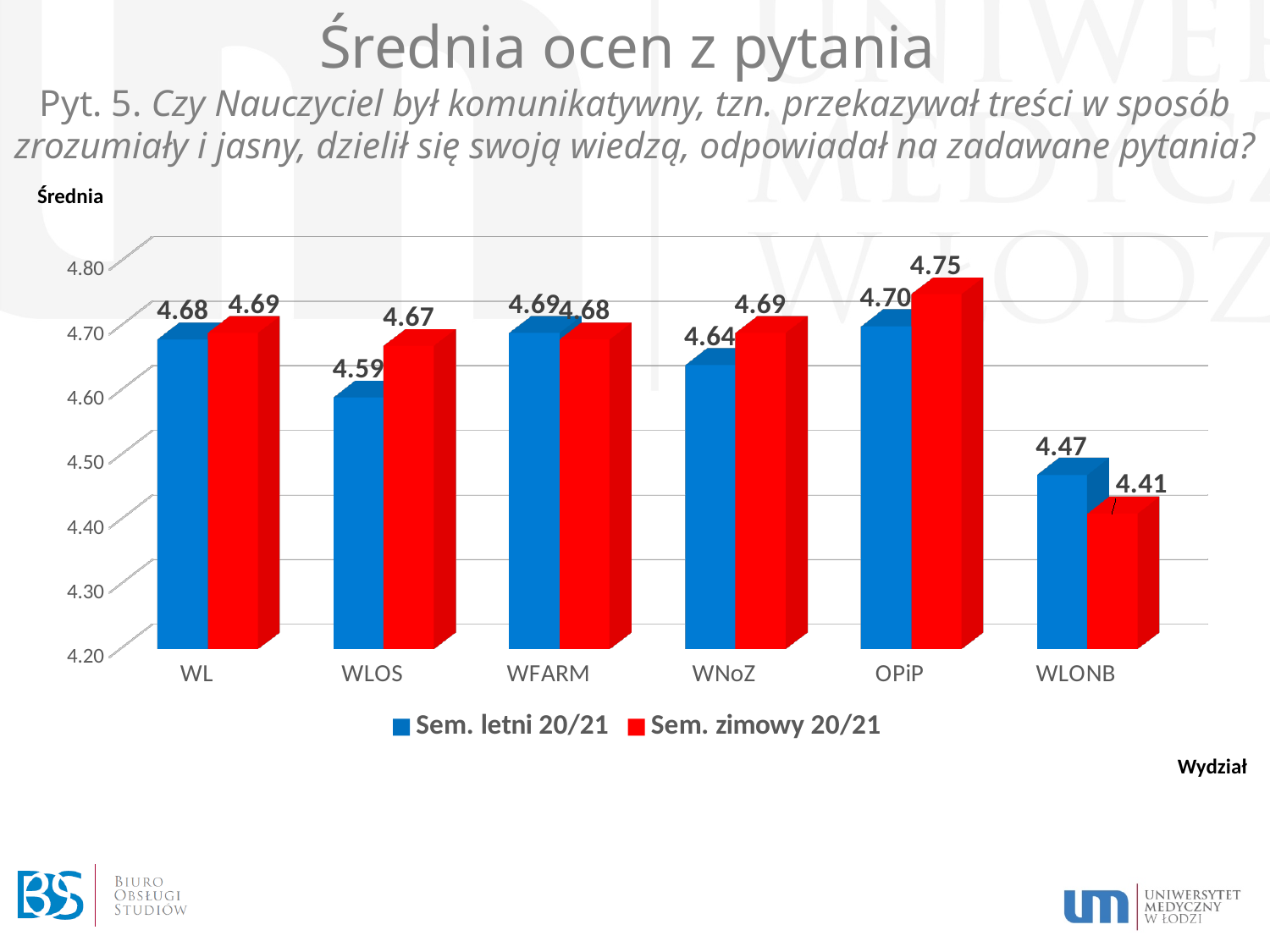
How many series does the legend list? 2 Is the value for WNoZ in Sem. letni 20/21 greater or less than 4.60? greater What kind of chart is shown on the slide? bar chart Which category has the lowest value in Sem. letni 20/21? WLONB What is the value for WLONB in Sem. zimowy 20/21? 4.41 What is the difference between the Sem. zimowy 20/21 and Sem. letni 20/21 values for WLOS? 0.08 How many categories are shown on the x axis? 6 What colour represents Sem. zimowy 20/21 in the chart? red What is the value for OPiP in Sem. zimowy 20/21? 4.75 Which is larger for WLONB: Sem. letni 20/21 or Sem. zimowy 20/21? Sem. letni 20/21 What is the value for WLOS in Sem. letni 20/21? 4.59 Which category has the highest value in Sem. zimowy 20/21? OPiP